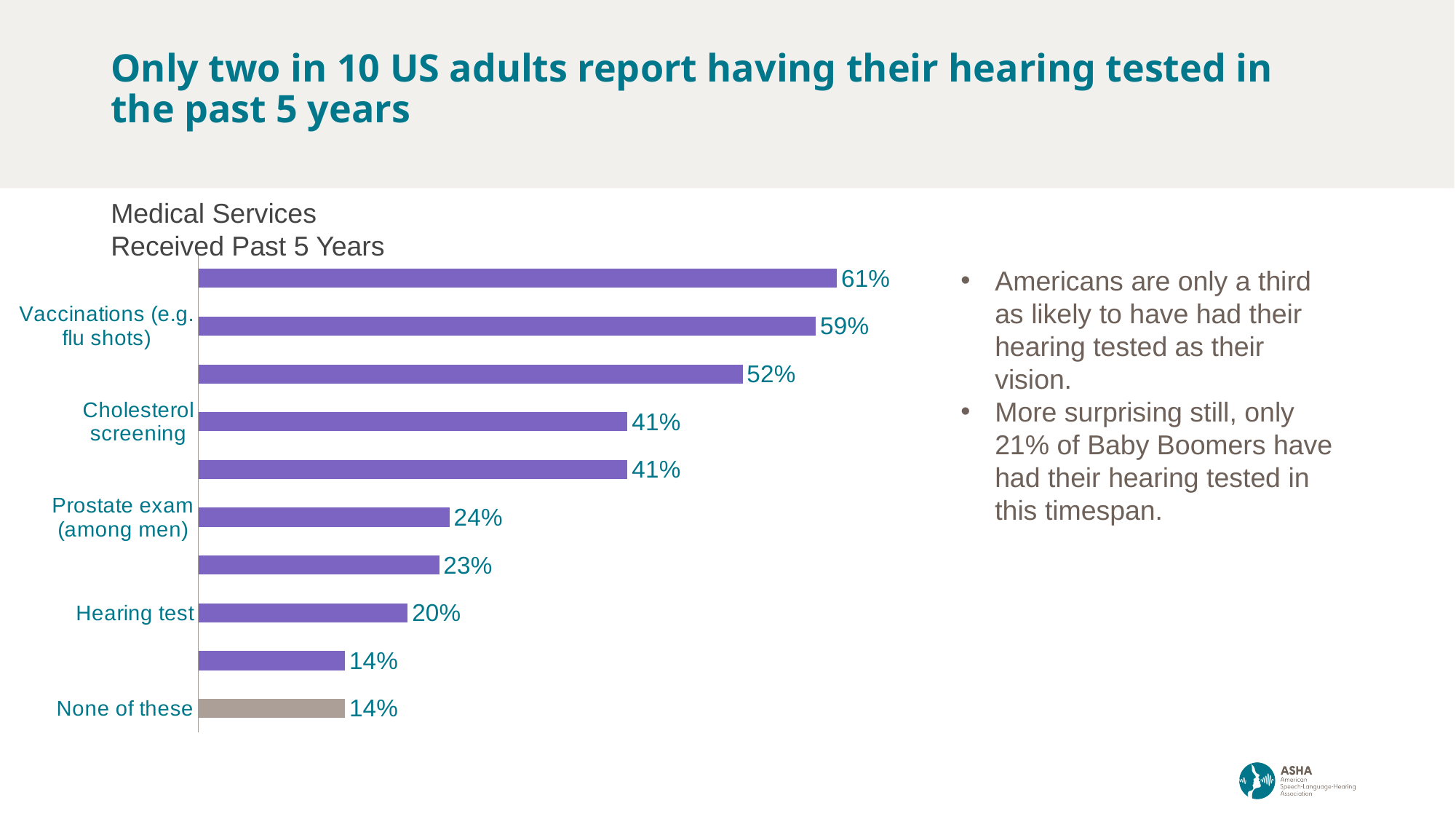
What percentage is shown for Cholesterol screening? 41% Which is larger, the value for Cholesterol screening or the value for Prostate exam (among men)? Cholesterol screening What percentage is shown for Hearing test? 20% What percentage is shown for Vaccinations (e.g. flu shots)? 59% What percentage is shown for None of these? 14% What is the lowest value shown on the chart? 14% What is the highest value shown on the chart? 61% What percentage is shown for Prostate exam (among men)? 24% What is the difference between the values for Vaccinations (e.g. flu shots) and Hearing test? 39 percentage points How many bars are plotted on the chart? 10 What type of chart is shown on the slide? Bar chart What is the title of the chart? Medical Services Received Past 5 Years